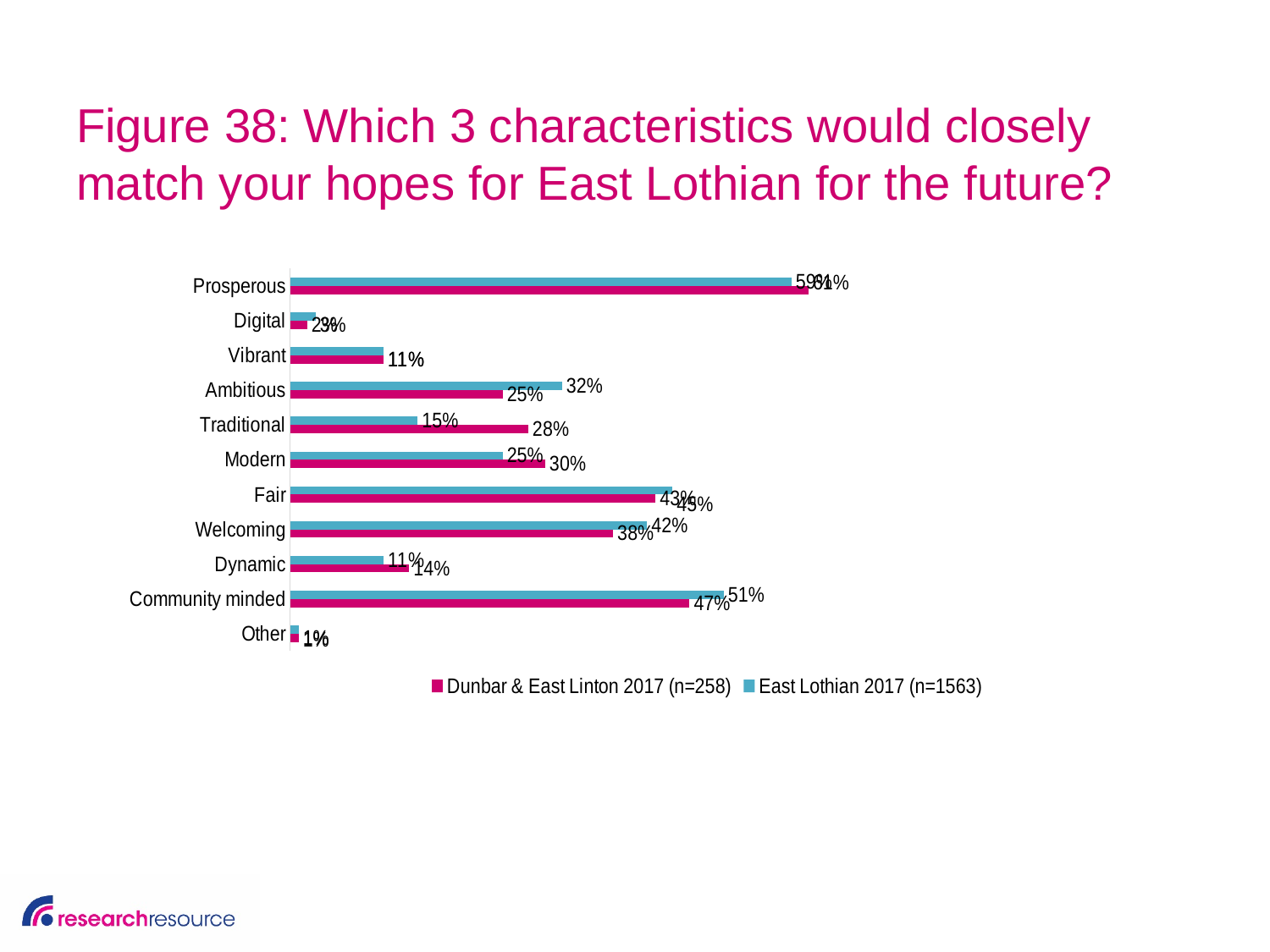
Which characteristic has the highest value in the Dunbar & East Linton 2017 (n=258) series? Prosperous What is the value for Ambitious in the East Lothian 2017 (n=1563) series? 32% How many series does the legend list? 2 What is the value for Modern in the Dunbar & East Linton 2017 (n=258) series? 30% What is the value for Traditional in the Dunbar & East Linton 2017 (n=258) series? 28% How many characteristics are listed on the chart? 11 For Traditional, what is the difference between the Dunbar & East Linton 2017 value and the East Lothian 2017 value? 13 percentage points What is the value for Welcoming in the East Lothian 2017 (n=1563) series? 42% For Ambitious, how much higher is the East Lothian 2017 value than the Dunbar & East Linton 2017 value? 7 percentage points Which characteristic has the lowest value in the chart? Other What is the value for Community minded in the Dunbar & East Linton 2017 (n=258) series? 47% For Dynamic, which series has the larger value? Dunbar & East Linton 2017 (n=258)